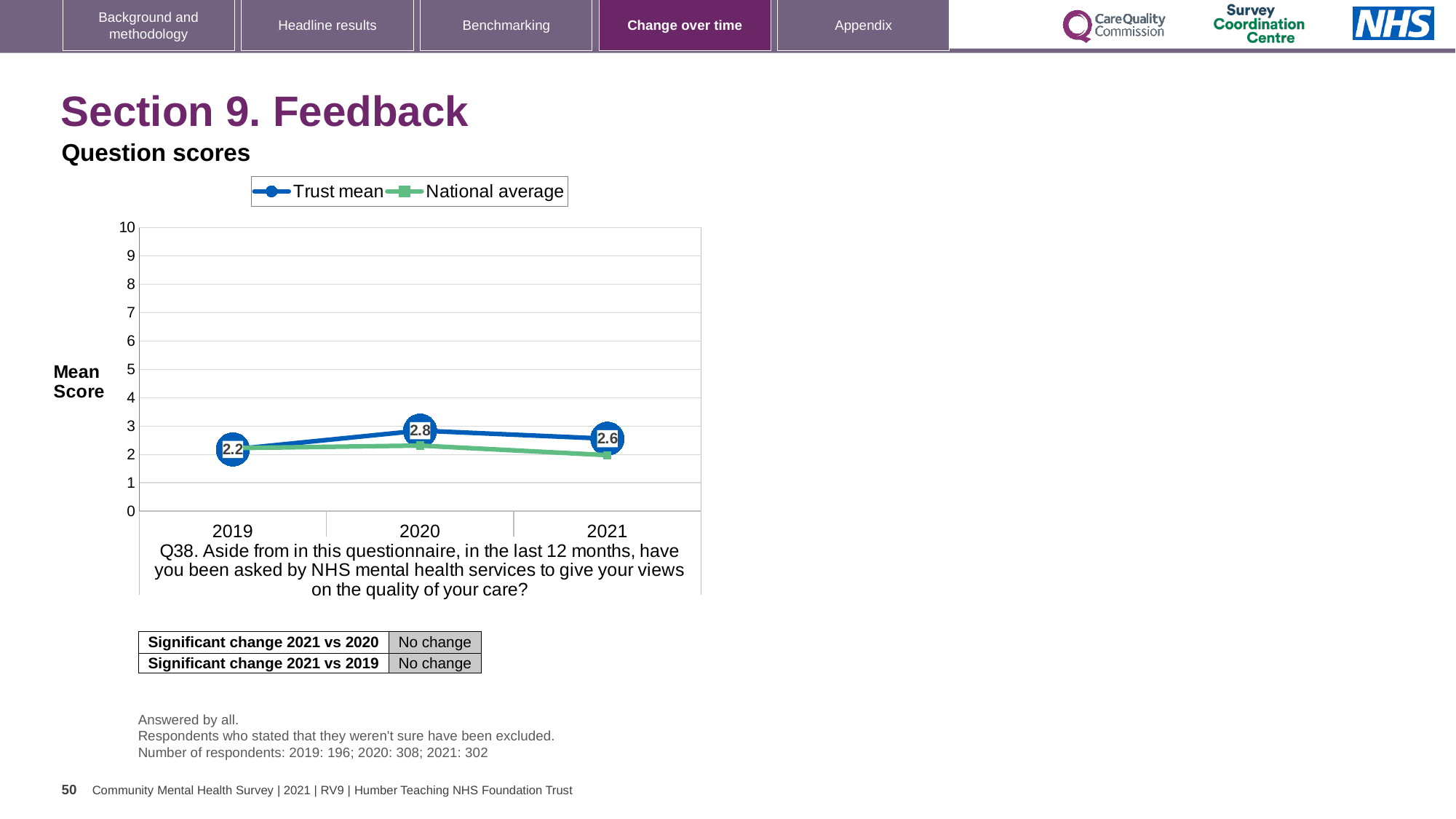
How many years are plotted on the x axis of the chart? 3 Which is larger, the Trust mean score for 2021 or for 2019? 2021 Is the National average value for 2021 greater or less than 3? less What is the Trust mean score for 2020? 2.8 Does the Trust mean score rise or fall from 2020 to 2021? fall What is the Trust mean score for 2021? 2.6 What is the difference between the Trust mean scores for 2020 and 2019? 0.6 In which year is the Trust mean score lowest? 2019 What is the Trust mean score for 2019? 2.2 What kind of chart is shown on the slide? line chart In which year is the Trust mean score highest? 2020 How many series does the legend list? 2